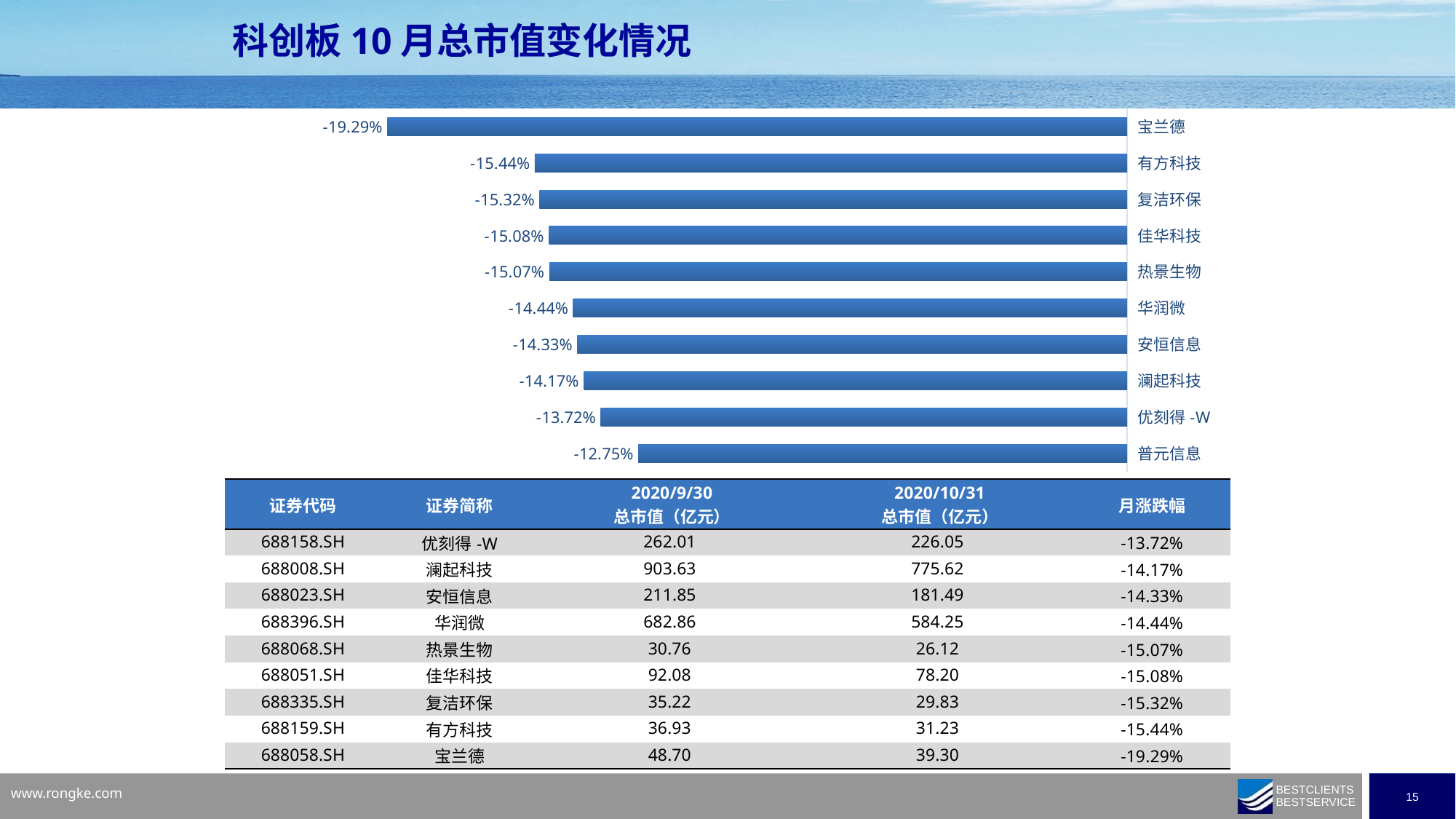
What is the value shown for 宝兰德 in the bar chart? -19.29% How many categories (bars) are shown in the bar chart? 10 Reading the bars from top to bottom, do the values increase or decrease? Increase Which category in the bar chart has the lowest (most negative) value? 宝兰德 What is the value shown for 华润微 in the bar chart? -14.44% What is the value shown for 澜起科技 in the bar chart? -14.17% What is the difference between the values for 有方科技 and 优刻得 -W in the bar chart? 1.72 percentage points What kind of chart is shown on the slide? Bar chart What is the difference between the values for 宝兰德 and 普元信息 in the bar chart? 6.54 percentage points What is the value shown for 普元信息 in the bar chart? -12.75% Which has the larger (less negative) value in the bar chart, 安恒信息 or 复洁环保? 安恒信息 Which category in the bar chart has the highest (least negative) value? 普元信息